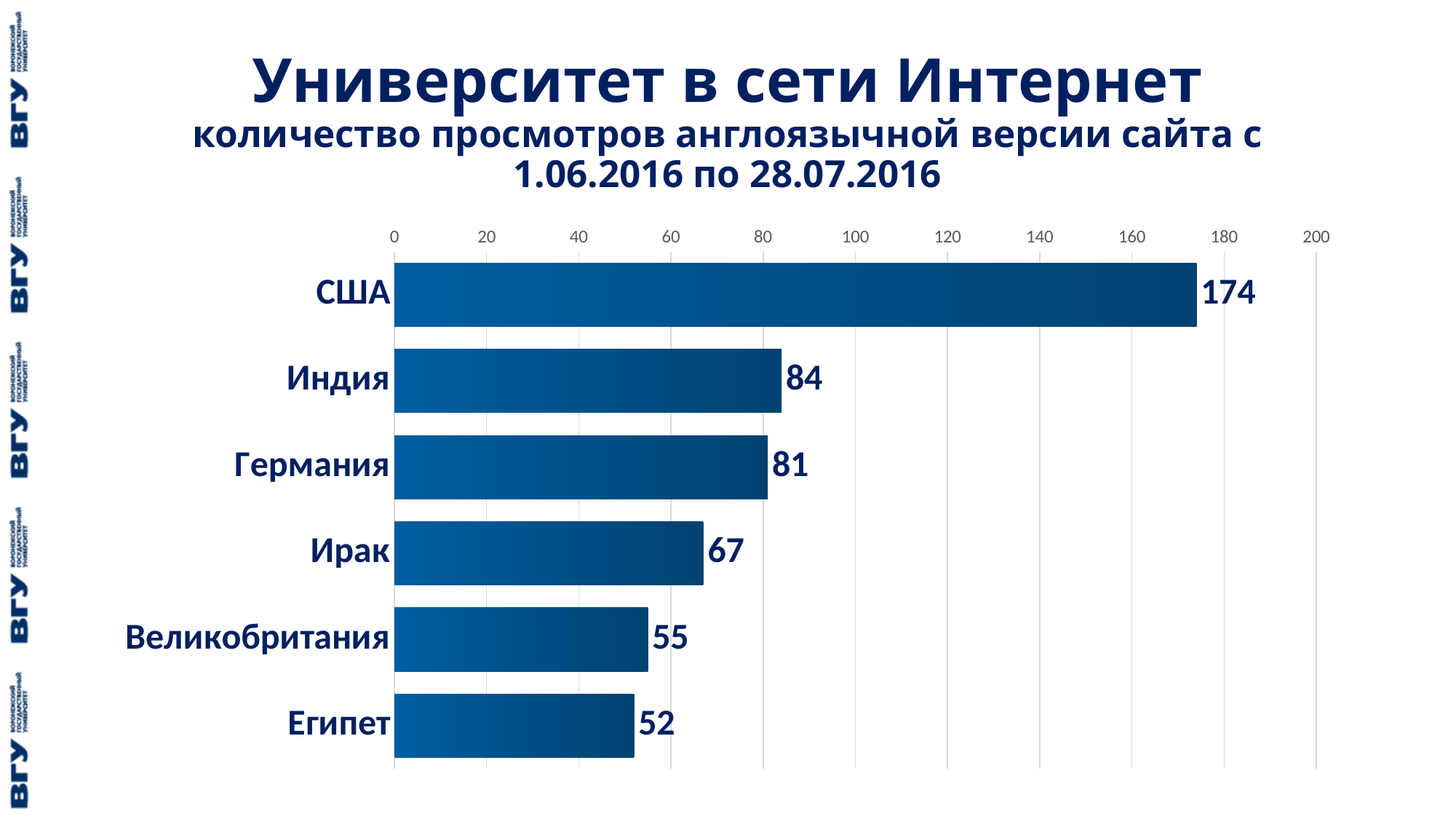
How many countries are shown in the chart? 6 What is the value for Египет? 52 Is the value for Великобритания greater or less than 60? less What is the difference between the values for Ирак and Великобритания? 12 What is the difference between the values for США and Индия? 90 Which country has the lowest value? Египет Which country has the highest value? США What is the value for США? 174 Which is larger, the value for Индия or the value for Ирак? Индия What is the value for Германия? 81 What is the maximum value shown on the horizontal axis? 200 What kind of chart is shown on the slide? bar chart